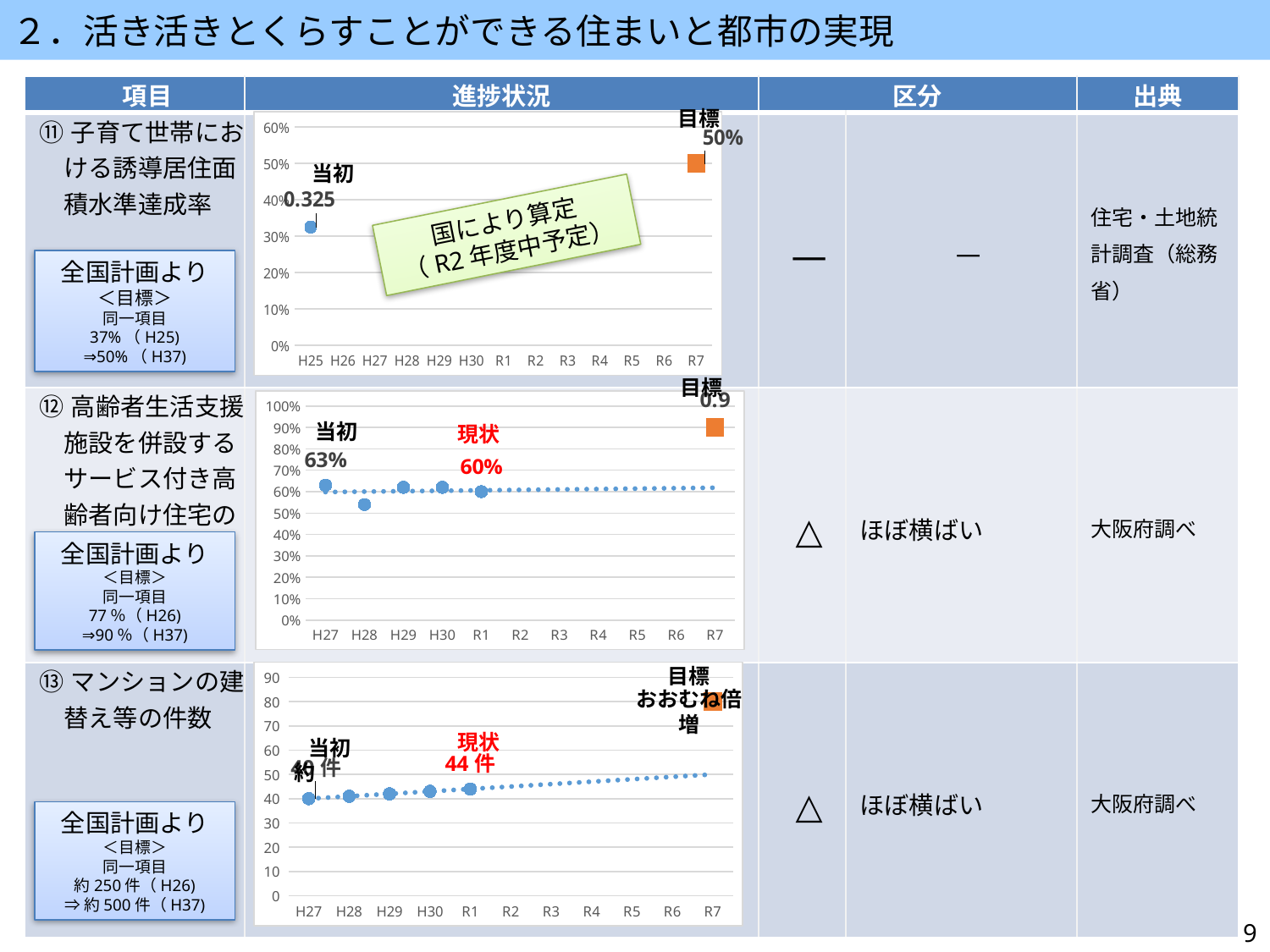
In the chart for ⑬ マンションの建替え等の件数, what is the 現状 value shown for R1? 44件 In the chart for ⑬ マンションの建替え等の件数, is the 目標 marker at R7 greater or less than 70? greater In the chart for ⑫ 高齢者生活支援施設を併設するサービス付き高齢者向け住宅, which year has the lowest plotted value? H28 In the chart for ⑪ 子育て世帯における誘導居住面積水準達成率, what is the 当初 value shown for H25? 0.325 In the chart for ⑫ 高齢者生活支援施設を併設するサービス付き高齢者向け住宅, what is the 現状 value shown for R1? 60% In the chart for ⑪ 子育て世帯における誘導居住面積水準達成率, how many year labels are on the x axis? 13 In the chart for ⑫ 高齢者生活支援施設を併設するサービス付き高齢者向け住宅, what is the difference between the 当初 value (H27) and the 現状 value (R1)? 3 percentage points In the chart for ⑫ 高齢者生活支援施設を併設するサービス付き高齢者向け住宅, what is the 目標 value shown at R7? 0.9 In the chart for ⑪ 子育て世帯における誘導居住面積水準達成率, what is the 目標 value shown at R7? 50% In the chart for ⑫ 高齢者生活支援施設を併設するサービス付き高齢者向け住宅, what is the 当初 value shown for H27? 63% In the chart for ⑫ 高齢者生活支援施設を併設するサービス付き高齢者向け住宅, is the value for H28 greater or less than 60%? less In the chart for ⑬ マンションの建替え等の件数, do the plotted values rise or fall from H27 to R1? rise